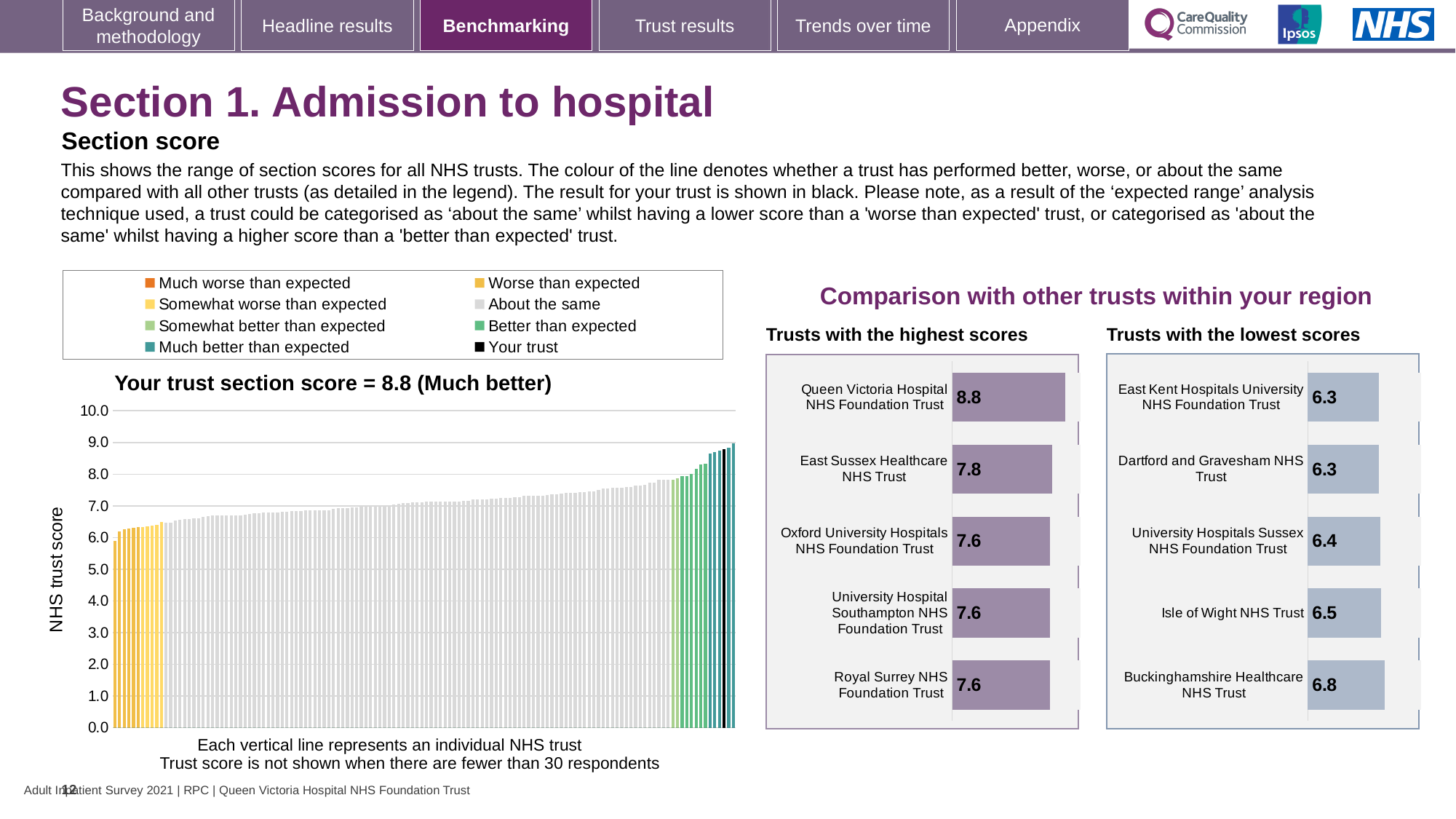
On the 'Trusts with the lowest scores' chart, what is the score for Isle of Wight NHS Trust? 6.5 On the 'Trusts with the highest scores' chart, which trust has the highest score? Queen Victoria Hospital NHS Foundation Trust On the 'Trusts with the highest scores' chart, what is the difference between the scores of Queen Victoria Hospital NHS Foundation Trust and East Sussex Healthcare NHS Trust? 1.0 On the 'Trusts with the highest scores' chart, what is the score for Queen Victoria Hospital NHS Foundation Trust? 8.8 How many entries does the legend above the 'Your trust section score' chart list? 8 On the 'Trusts with the lowest scores' chart, what is the difference between the scores of Buckinghamshire Healthcare NHS Trust and East Kent Hospitals University NHS Foundation Trust? 0.5 On the 'Trusts with the lowest scores' chart, which trust has the highest score? Buckinghamshire Healthcare NHS Trust How many trusts are shown on the 'Trusts with the highest scores' chart? 5 What kind of chart is the 'Your trust section score' chart on the left of the slide? Bar chart On the 'Your trust section score' chart, do the bar values rise or fall from left to right? Rise On the 'Trusts with the highest scores' chart, what is the score for East Sussex Healthcare NHS Trust? 7.8 On the 'Trusts with the lowest scores' chart, which has the larger score: Isle of Wight NHS Trust or University Hospitals Sussex NHS Foundation Trust? Isle of Wight NHS Trust